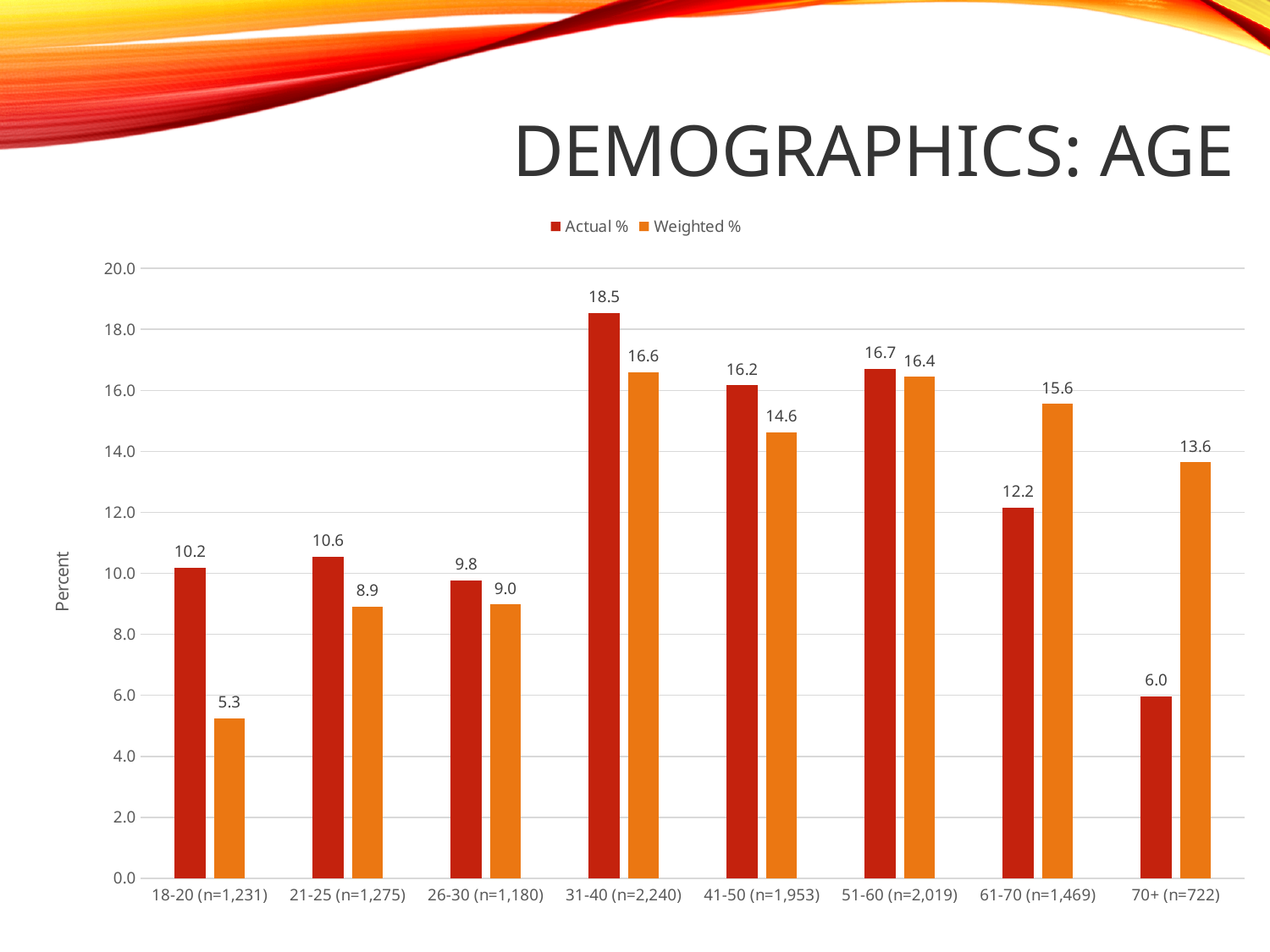
Which is larger for the 61-70 (n=1,469) age group, the Actual % or the Weighted %? Weighted % What is the label on the vertical axis? Percent What is the Actual % value for the 31-40 (n=2,240) age group? 18.5 Is the Actual % value for the 41-50 (n=1,953) age group greater or less than 14.0? greater Which age group has the lowest Weighted % value? 18-20 (n=1,231) Which age group has the highest Actual % value? 31-40 (n=2,240) What is the Weighted % value for the 18-20 (n=1,231) age group? 5.3 What is the Weighted % value for the 70+ (n=722) age group? 13.6 What is the difference between the Actual % and Weighted % values for the 70+ (n=722) age group? 7.6 How many age groups are shown on the x axis? 8 What kind of chart is shown on the slide? Bar chart How many series does the legend list? 2